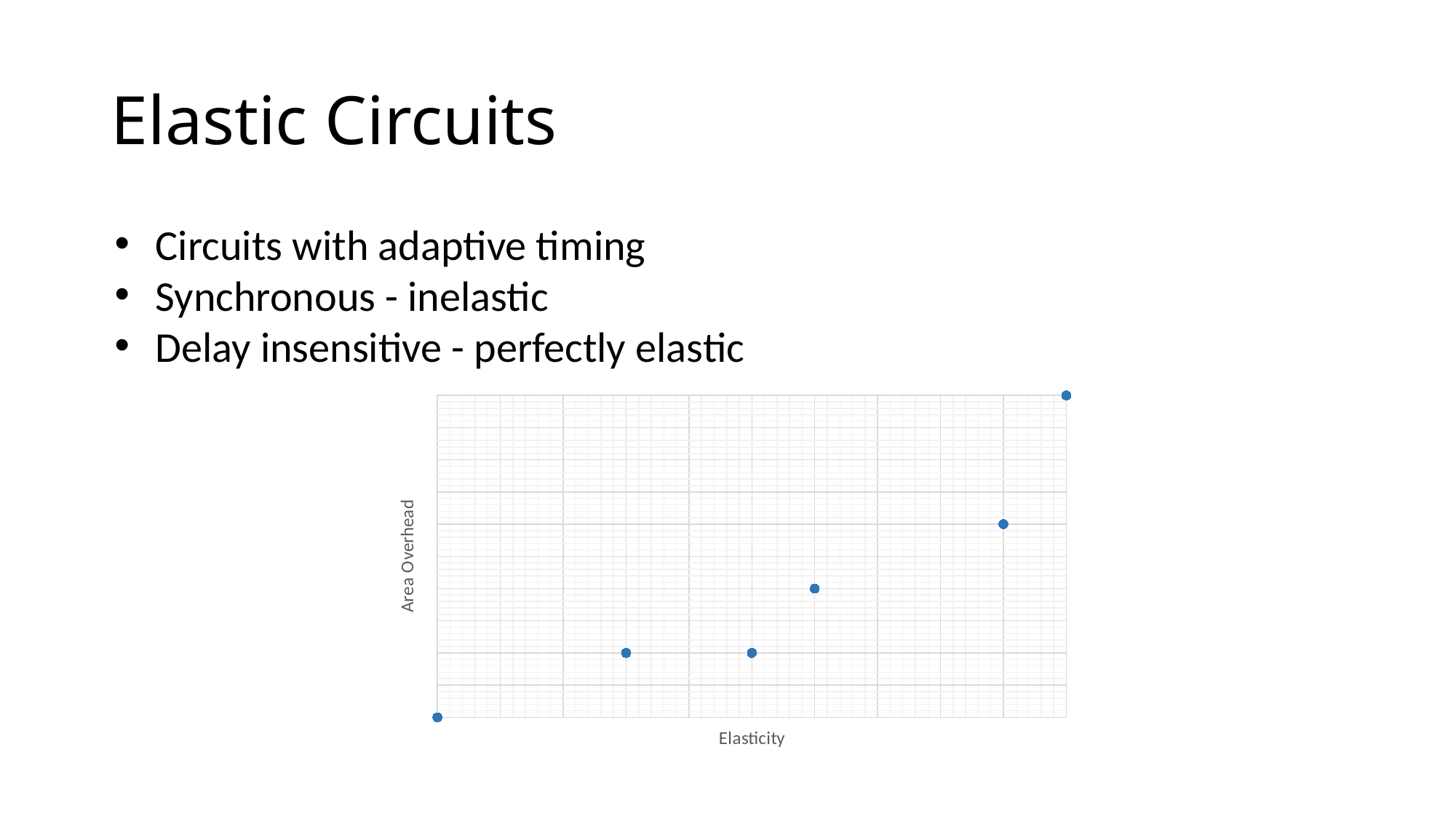
What is the label of the x axis of the chart? Elasticity What kind of chart is shown on the slide? scatter chart What is the label of the y axis of the chart? Area Overhead How many data points are plotted on the chart? 6 Which has the larger Area Overhead: the rightmost point or the leftmost point? the rightmost point Is the point with the highest Area Overhead at the left or the right end of the Elasticity axis? right Do the plotted values of Area Overhead generally rise or fall as Elasticity increases along the x axis? rise Is the point with the lowest Area Overhead at the left or the right end of the Elasticity axis? left